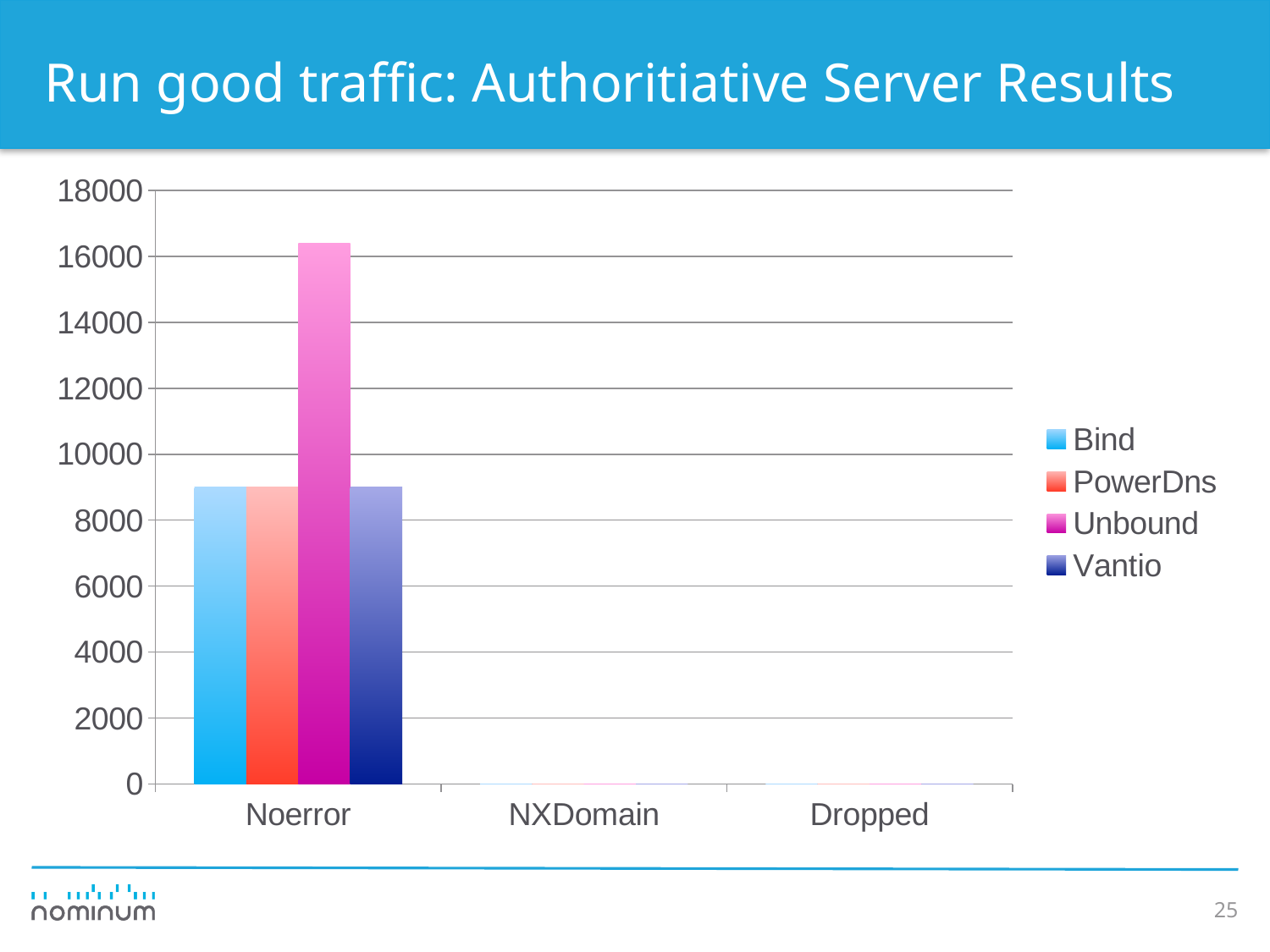
Is the value for PowerDns at Noerror greater or less than 12000? less How many series does the legend list? 4 Which category has the highest values across all series? Noerror What kind of chart is shown on the slide? bar chart Is the value for Unbound at Noerror greater or less than 14000? greater Is the value for Vantio at Noerror greater or less than 10000? less Which is larger for Noerror, the Unbound value or the Bind value? Unbound Which series is shown in magenta/pink in the legend? Unbound Which series has the highest value for Noerror? Unbound What is the title of the slide? Run good traffic: Authoritiative Server Results How many categories are shown on the x axis? 3